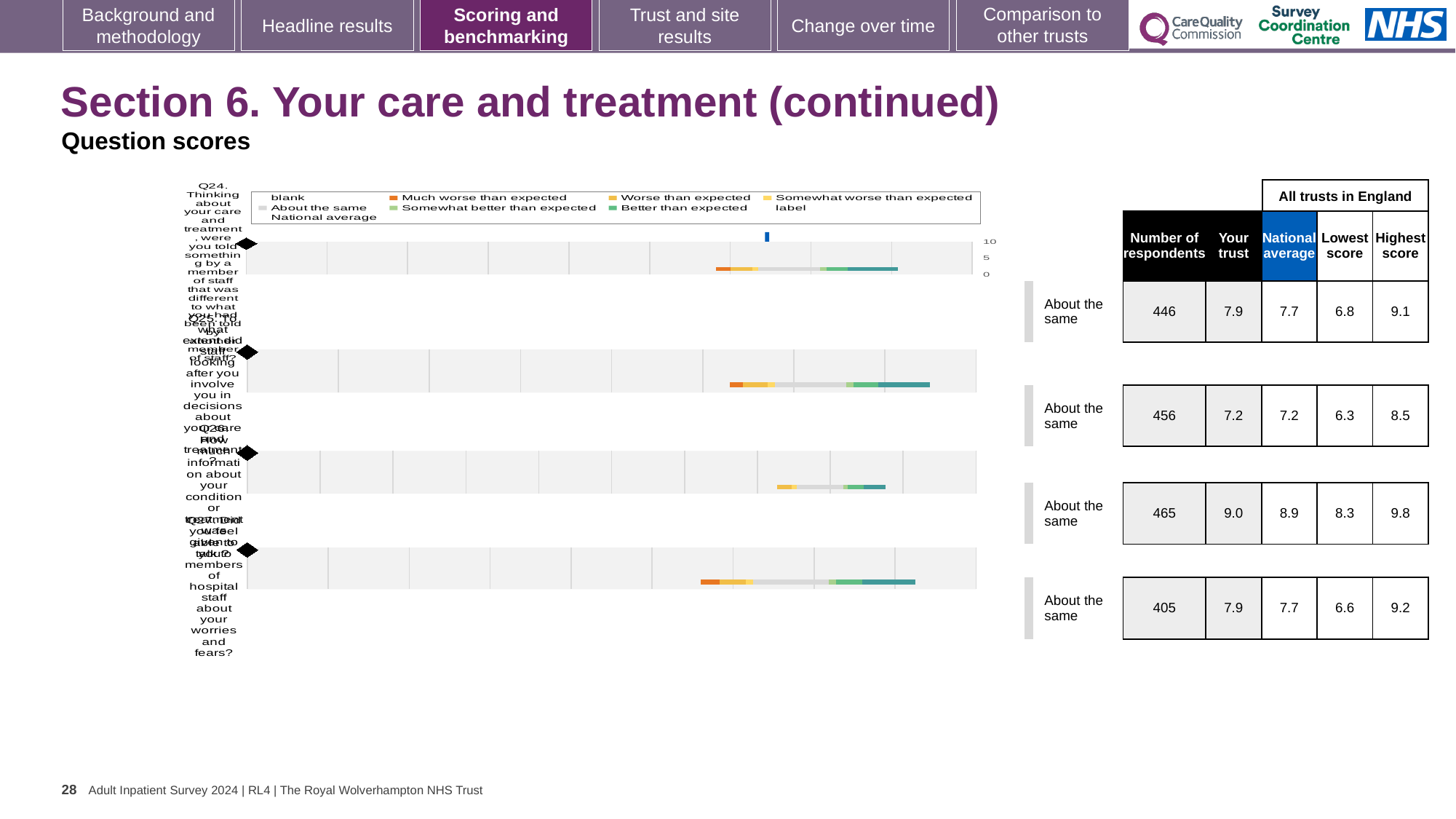
Which question has the highest 'Your trust' score? Q26 What is the difference between the highest score and the lowest score for Q26? 1.5 What is the 'Your trust' score for Q24? 7.9 What kind of chart is shown on the slide? Bar chart For Q24, which is larger: the 'Your trust' score or the national average? Your trust Which colour does the legend use for 'Much worse than expected'? Orange Is the 'Your trust' score for Q25 greater or less than 5? greater Which question has the lowest 'Your trust' score? Q25 How many questions (rows) are plotted in the chart? 4 What benchmark category is shown next to each of the four questions in the chart? About the same How many respondents are shown for Q27? 405 What is the national average score for Q26? 8.9